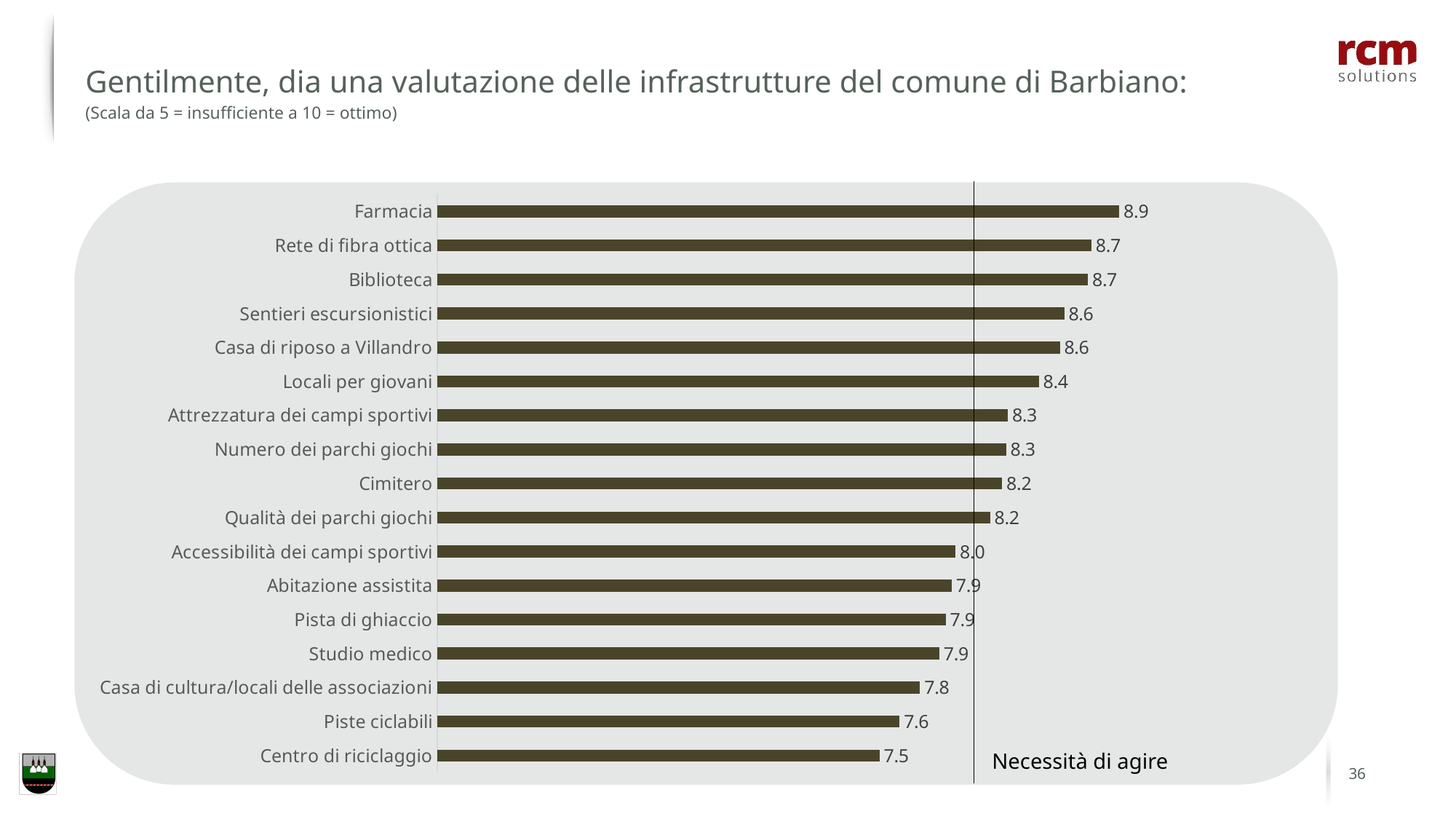
What is the value for Centro di riciclaggio? 7.5 What kind of chart is shown on the slide? Bar chart Which category has the highest value? Farmacia What label is written next to the vertical line in the chart? Necessità di agire How many categories are shown in the chart? 17 Which category has the lowest value? Centro di riciclaggio What is the value for Farmacia? 8.9 Which is larger, the value for Cimitero or the value for Studio medico? Cimitero What is the difference between the values for Sentieri escursionistici and Piste ciclabili? 1.0 What is the value for Piste ciclabili? 7.6 What is the difference between the values for Farmacia and Centro di riciclaggio? 1.4 What is the value for Locali per giovani? 8.4